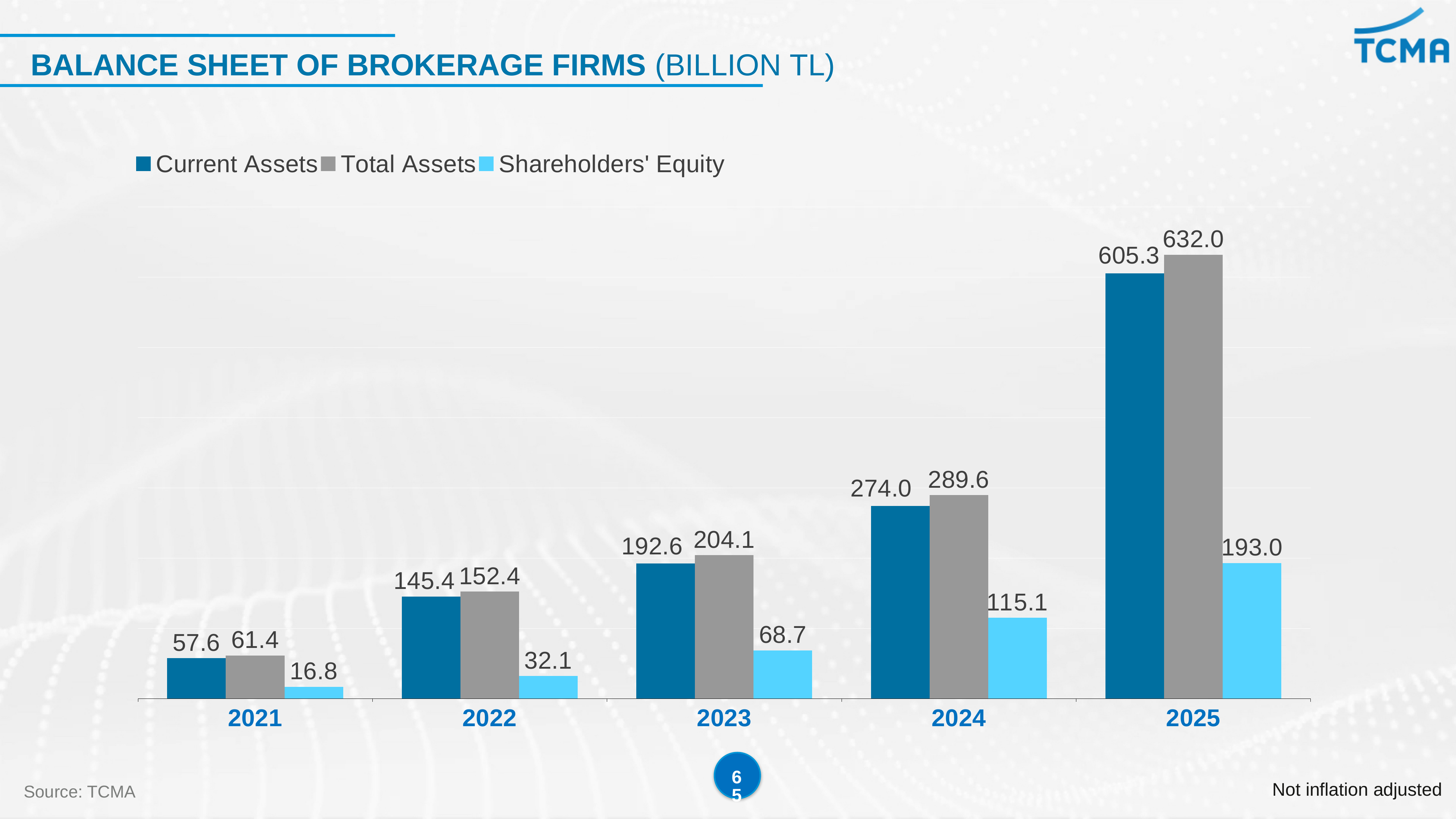
What is the value of Shareholders' Equity in 2021? 16.8 What is the difference between Shareholders' Equity in 2024 and in 2023? 46.4 In which year is Shareholders' Equity lowest? 2021 What kind of chart is shown on the slide? Bar chart In which year is Total Assets highest? 2025 Which is larger: Shareholders' Equity in 2025 or Current Assets in 2023? Shareholders' Equity in 2025 How many years are shown on the x axis? 5 How many series does the legend list? 3 What is the value of Total Assets in 2023? 204.1 What is the difference between Total Assets and Current Assets in 2025? 26.7 What is the value of Current Assets in 2024? 274.0 Do the Current Assets values rise or fall from 2021 to 2025? Rise